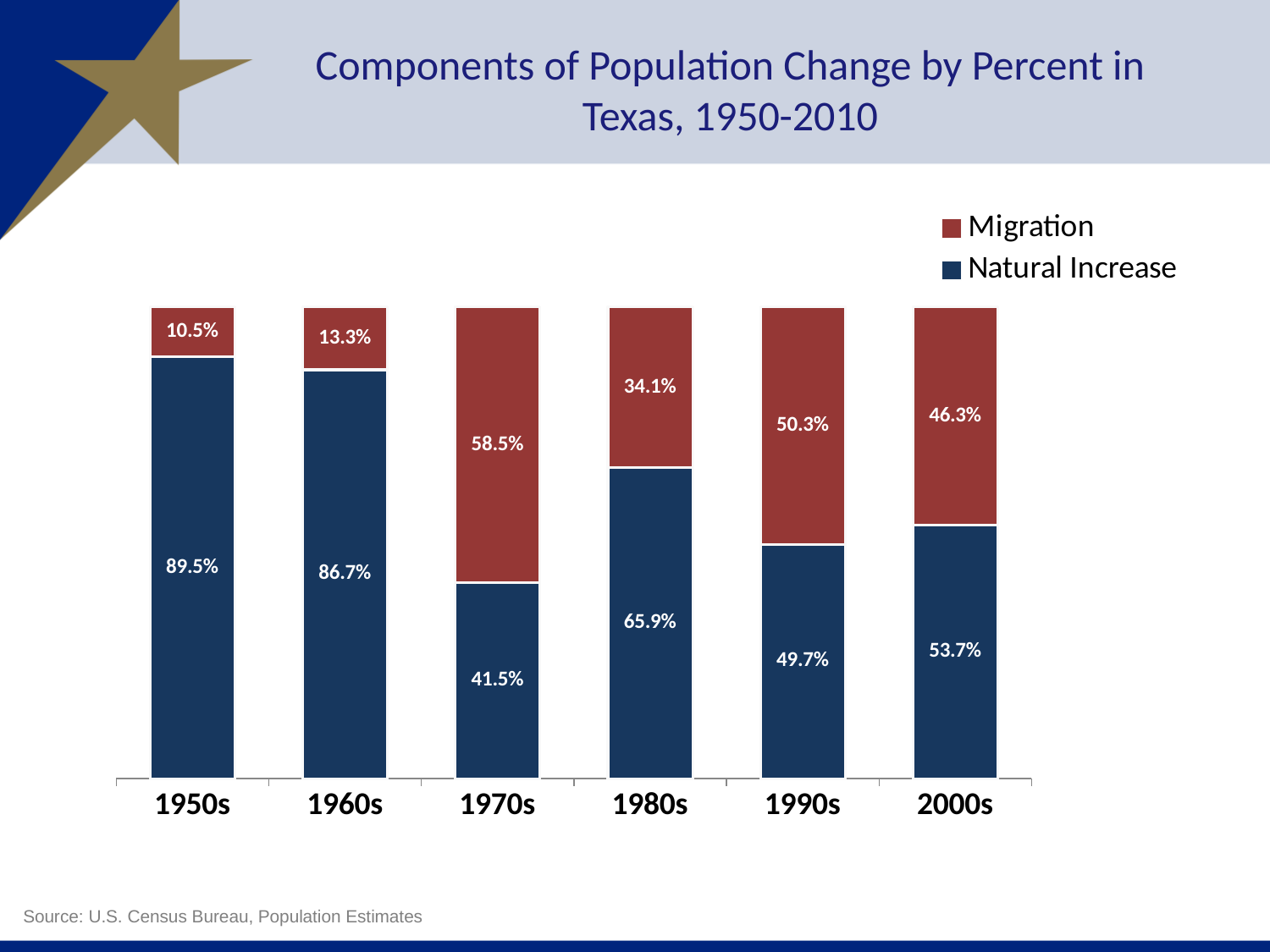
Does the Migration value rise or fall from the 1950s to the 1970s? Rise How many series does the legend list? 2 Which is larger, the Migration value for the 1980s or the Migration value for the 1990s? 1990s What is the Migration value for the 2000s? 46.3% What kind of chart is shown on the slide? Stacked bar chart Which decade has the lowest Natural Increase value? 1970s What is the difference between the Natural Increase values for the 1950s and the 1960s? 2.8% What is the Natural Increase value for the 1950s? 89.5% What is the Migration value for the 1970s? 58.5% Which colour represents Migration in the chart? Red Which decade has the highest Migration value? 1970s How many decades are shown on the x axis? 6